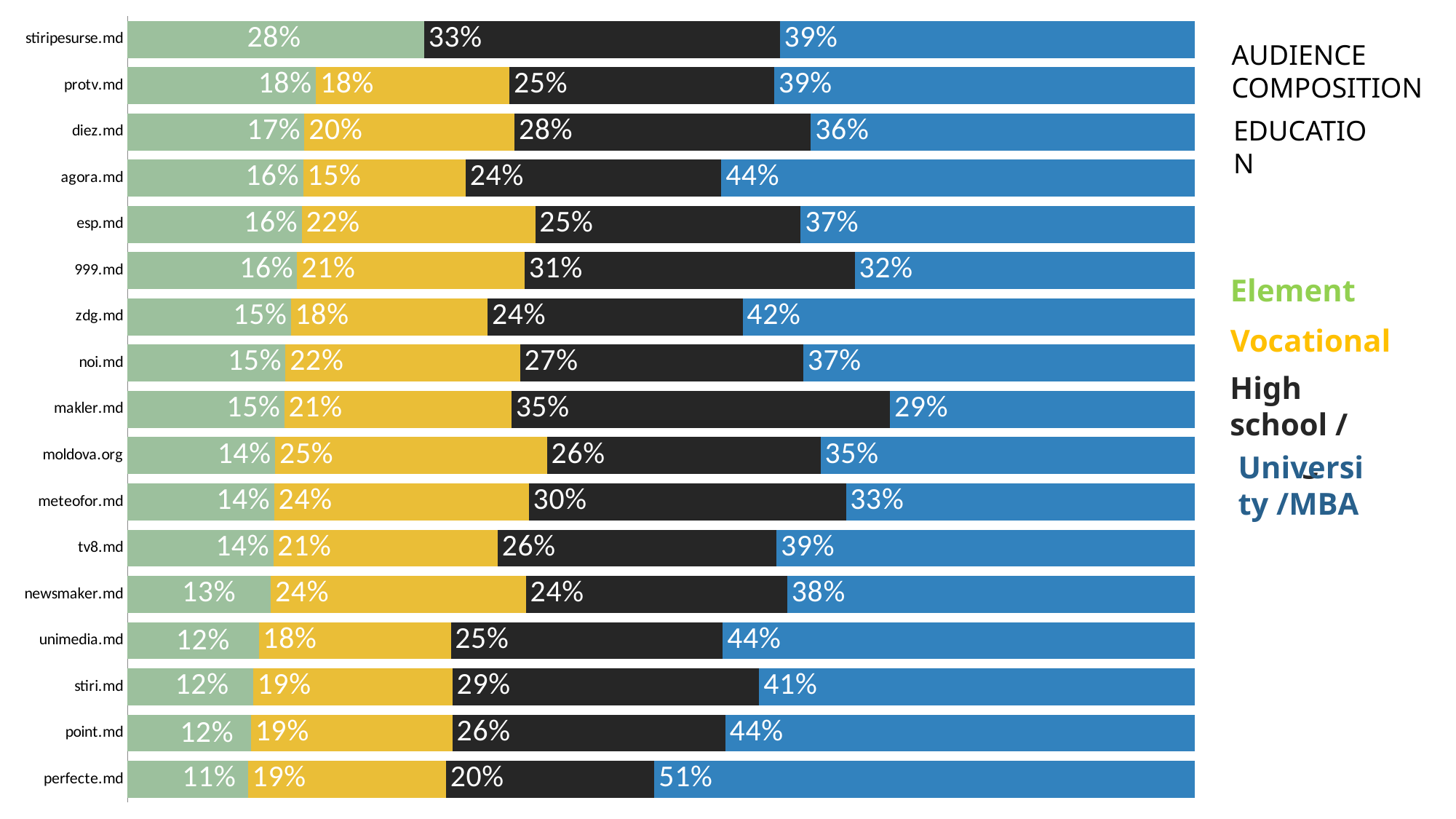
What kind of chart is shown on the slide? stacked bar chart What is the Vocational share for moldova.org? 25% Which website has the lowest Element share? perfecte.md What is the High school share for makler.md? 35% What is the difference between the University/MBA share of agora.md and that of 999.md? 12% Which is larger for makler.md: the High school share or the University/MBA share? High school What is the University/MBA share for perfecte.md? 51% Which colour represents the Vocational education level in the legend? yellow How many websites (categories) are listed on the chart? 17 How many education levels does the legend list? 4 Which website has the highest University/MBA share? perfecte.md What is the Element share for stiripesurse.md? 28%